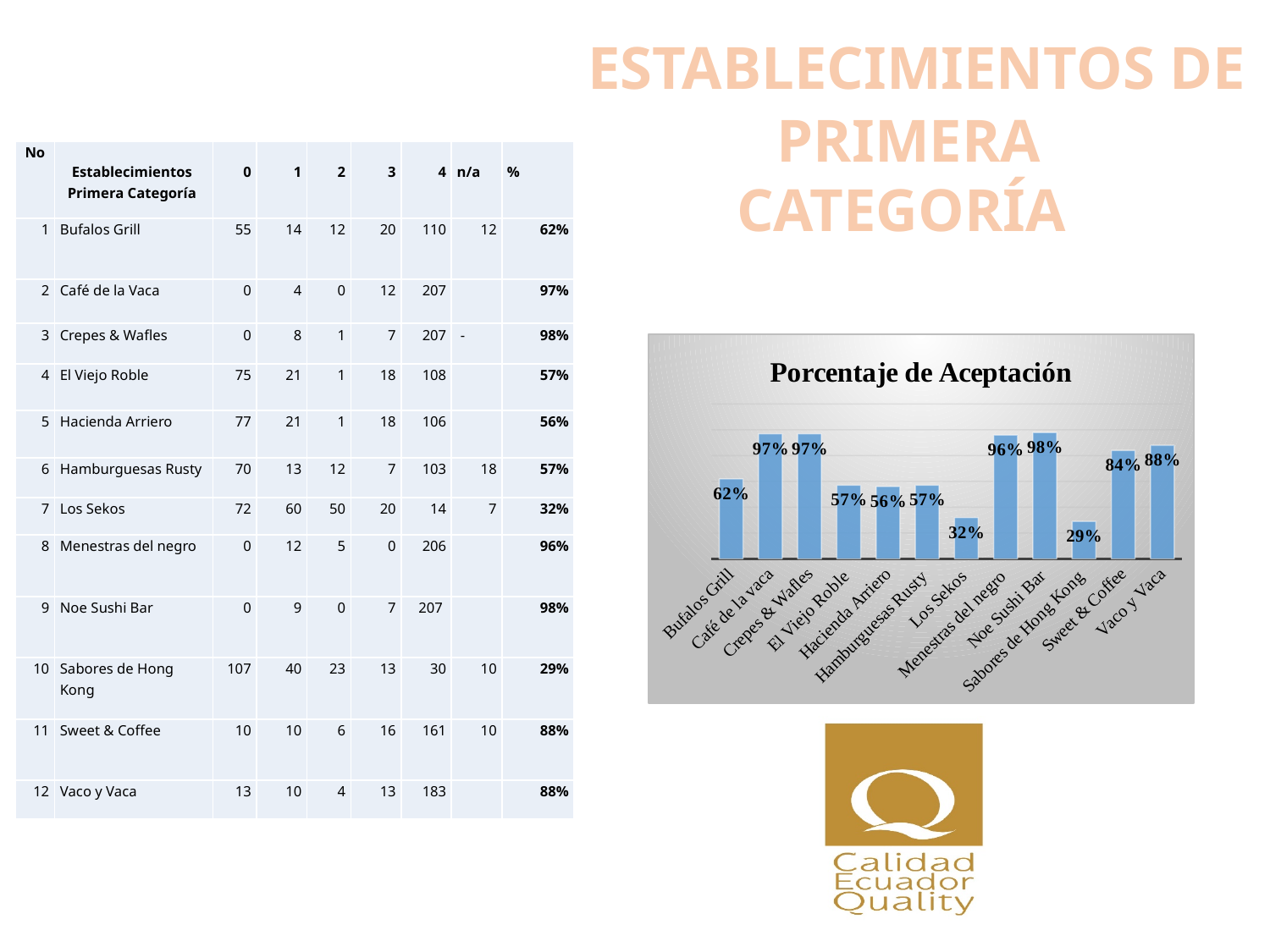
Which establishment has the highest value in the chart? Noe Sushi Bar What kind of chart is shown on the slide? bar chart What is the value shown for Bufalos Grill in the chart? 62% Which has a larger value in the chart, Hacienda Arriero or Sweet & Coffee? Sweet & Coffee What is the difference between the values for Café de la vaca and El Viejo Roble in the chart? 40% What is the difference between the values for Vaco y Vaca and Sabores de Hong Kong in the chart? 59% How many establishments are plotted in the chart? 12 What is the value shown for Menestras del negro in the chart? 96% Which establishment has the lowest value in the chart? Sabores de Hong Kong What is the title of the chart on the slide? Porcentaje de Aceptación What is the value shown for Sweet & Coffee in the chart? 84% What is the value shown for Los Sekos in the chart? 32%